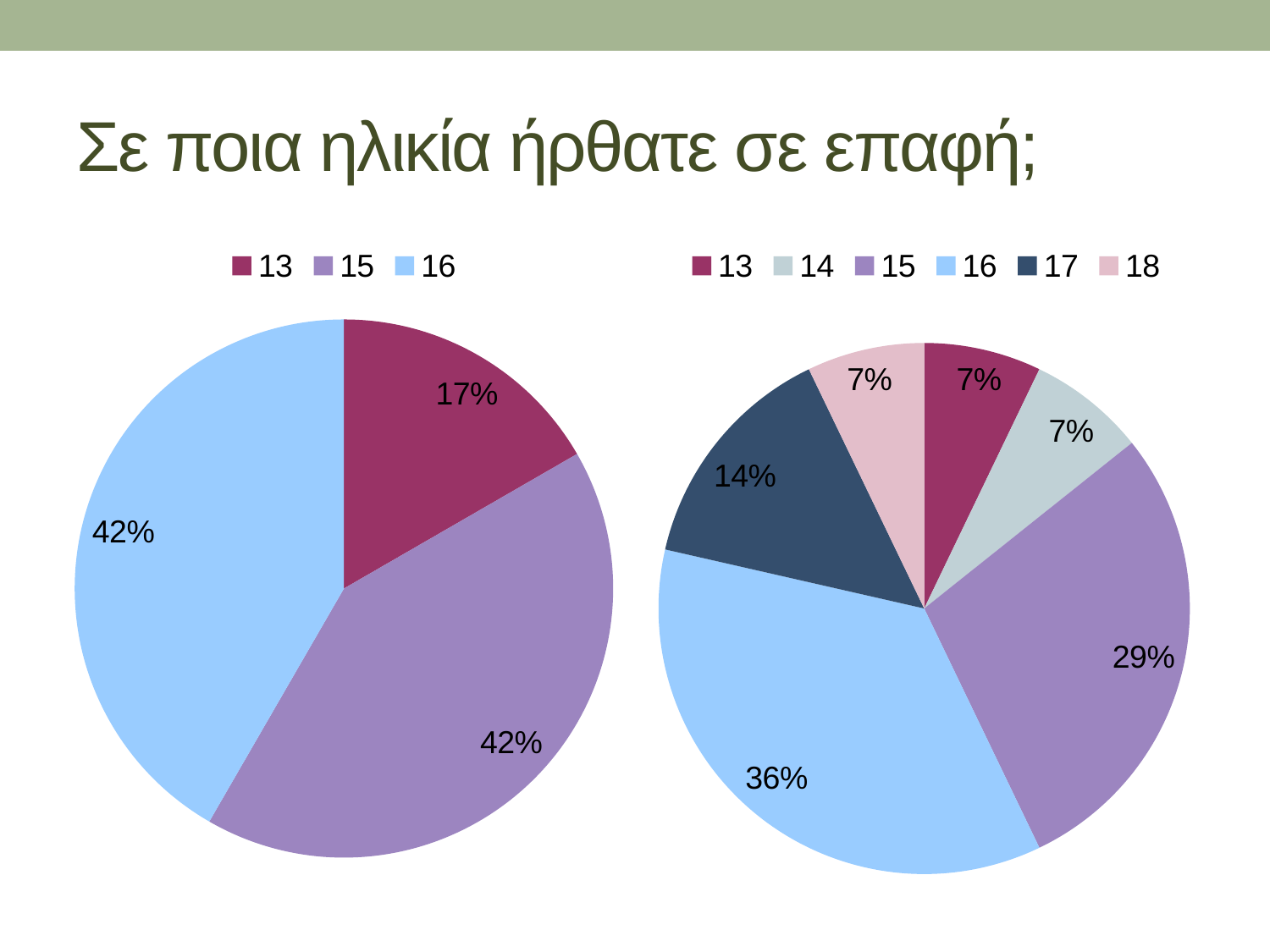
In the right pie chart, which is larger, the share for age 17 or the share for age 18? 17 In the left pie chart, what share is labelled for age 13? 17% In the right pie chart, what is the difference between the share for age 16 and the share for age 15? 7% In the left pie chart, what share is labelled for age 16? 42% In the right pie chart, how many slices are there? 6 In the left pie chart, how many slices are there? 3 In the right pie chart, what share is labelled for age 17? 14% In the right pie chart, which age has the largest slice? 16 In the right pie chart, what share is labelled for age 15? 29% In the left pie chart, which age has the smallest slice? 13 In the left pie chart, what is the difference between the share for age 15 and the share for age 13? 25% What type of chart is shown on the left of the slide? Pie chart